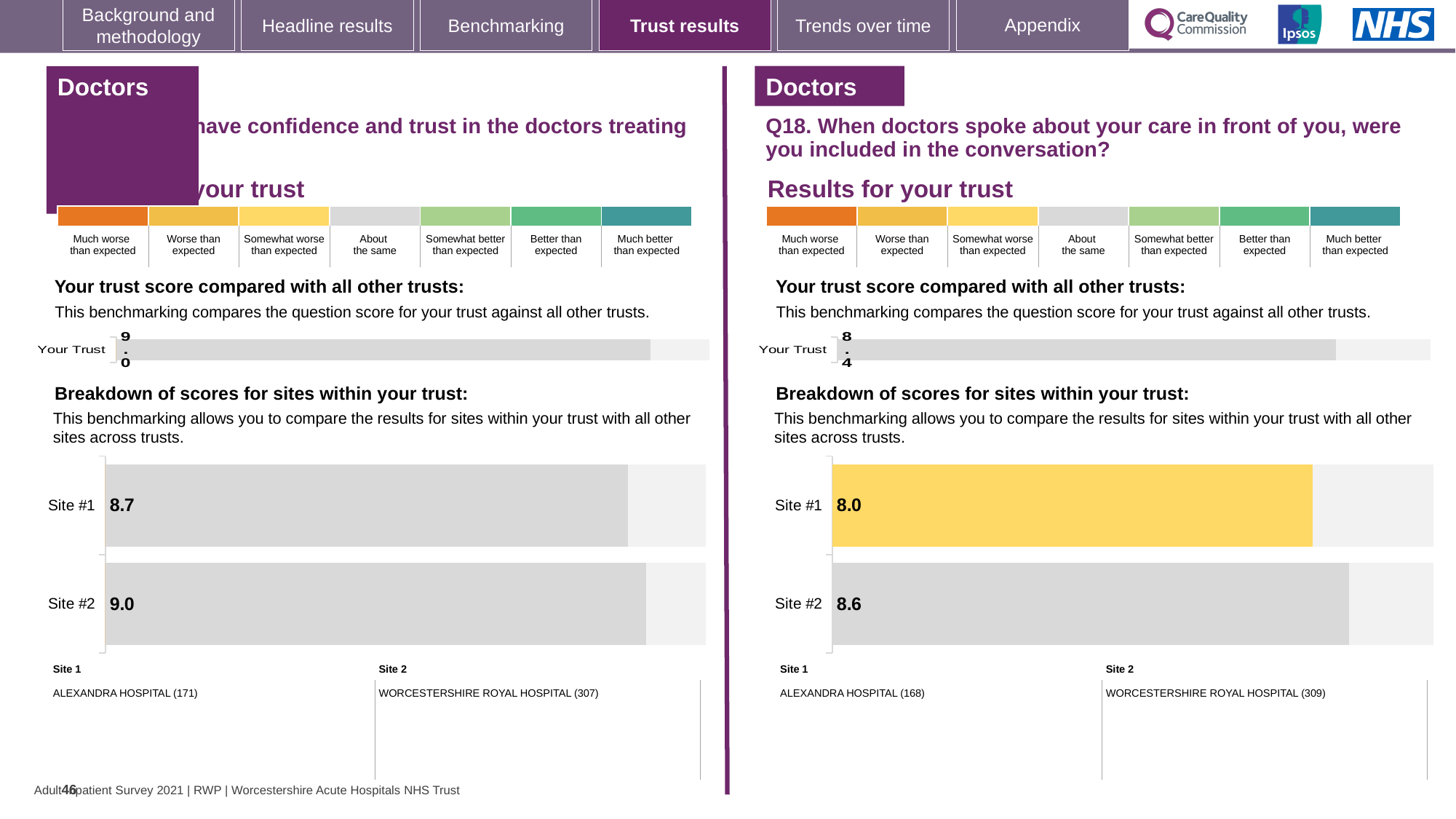
On the left-hand side of the slide, what is the score shown for Site #2 in the breakdown of scores for sites within your trust? 9.0 In the Q18 breakdown of scores for sites within your trust, what is the score for Site #1? 8.0 On the left-hand side of the slide, which site has the lower score in the breakdown of scores for sites? Site #1 What type of chart is used for the Q18 breakdown of scores for sites within your trust? Bar chart How many sites are shown in the Q18 breakdown of scores for sites within your trust chart? 2 On the left-hand side of the slide, what is the score shown for Site #1 in the breakdown of scores for sites within your trust? 8.7 In the Q18 breakdown of scores for sites, which site has the higher score? Site #2 In the Q18 breakdown of scores for sites within your trust, what is the score for Site #2? 8.6 In the Q18 trust score comparison chart, what is the 'Your Trust' score? 8.4 On the left-hand side of the slide, what is the difference between the Site #2 and Site #1 scores in the breakdown of scores for sites? 0.3 On the left-hand side of the slide, what is the 'Your Trust' score in the trust score comparison chart? 9.0 In the Q18 breakdown of scores for sites, what is the difference between the Site #2 and Site #1 scores? 0.6